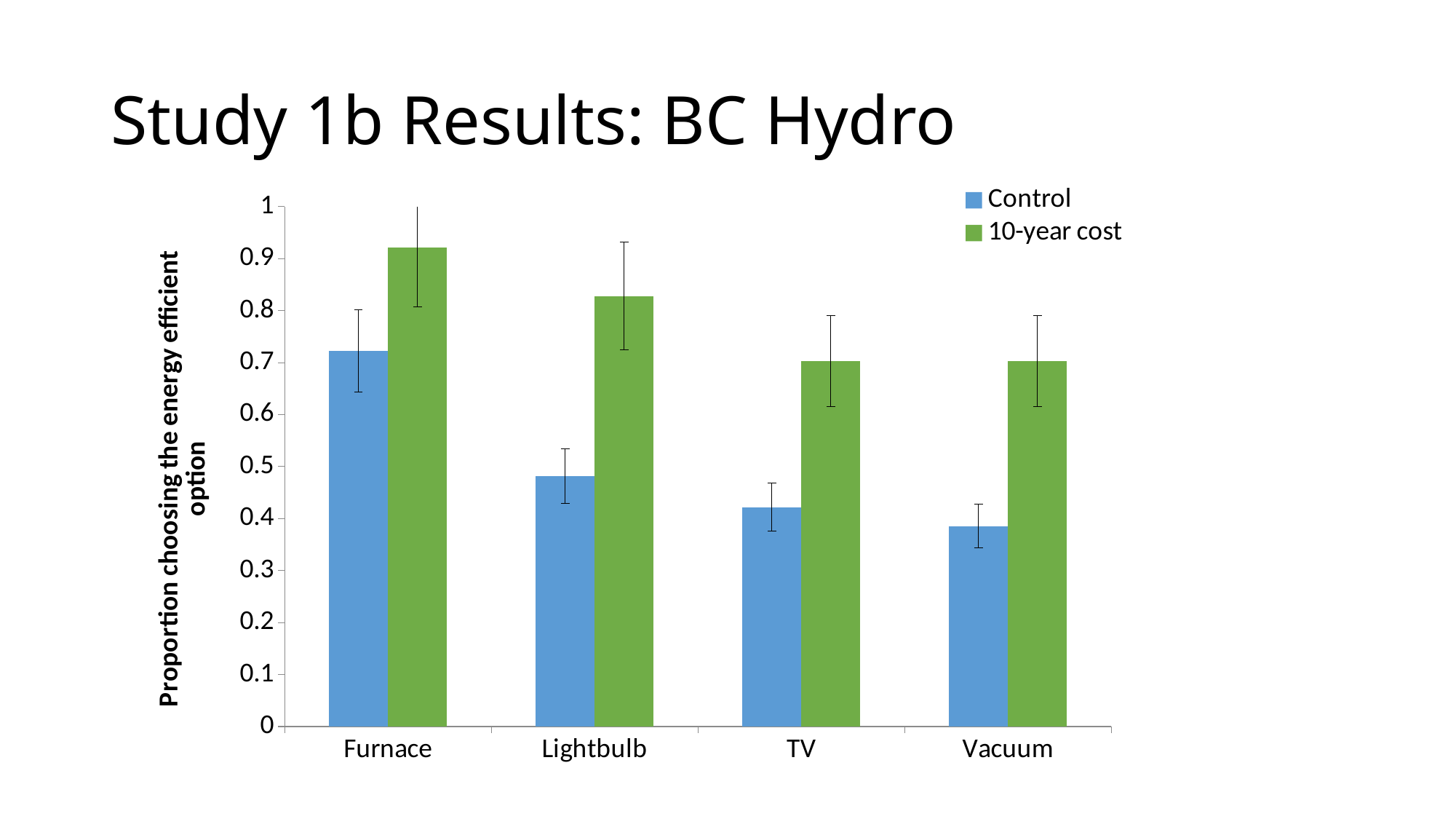
Is the 10-year cost value for TV greater or less than 0.6? greater Is the Control value for Vacuum greater or less than 0.5? less How many series does the legend list? 2 Which category has the highest Control bar? Furnace Which is larger, the Control value for Furnace or the Control value for Lightbulb? Furnace Is the 10-year cost value for Lightbulb greater or less than 0.8? greater Which category has the highest 10-year cost bar? Furnace What is the label on the y axis? Proportion choosing the energy efficient option Do the Control values rise or fall from Furnace to Vacuum along the x axis? fall How many product categories are shown on the x axis? 4 What kind of chart is shown on the slide? Bar chart